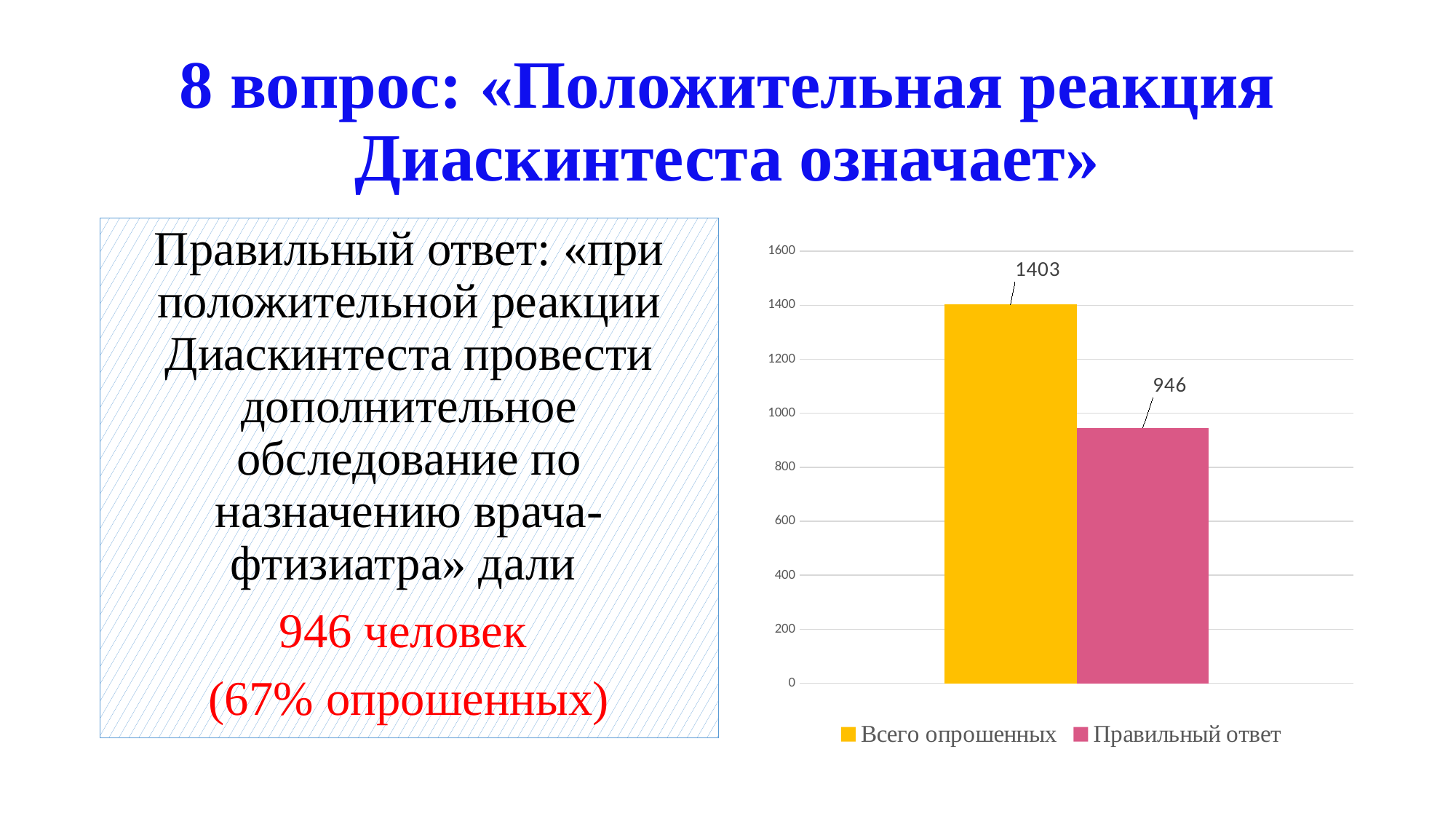
Is the value for "Правильный ответ" greater or less than 1000? less Which is larger: the value for "Всего опрошенных" or the value for "Правильный ответ"? Всего опрошенных What is the value for "Всего опрошенных" in the chart? 1403 What is the difference between the values for "Всего опрошенных" and "Правильный ответ"? 457 What is the value for "Правильный ответ" in the chart? 946 Which series has the lower value in the chart? Правильный ответ Is the value for "Всего опрошенных" greater or less than 1200? greater How many series does the legend list? 2 Which series has the higher value in the chart? Всего опрошенных What kind of chart is shown on the slide? bar chart How many bars are plotted in the chart? 2 What colour is the bar for "Правильный ответ"? pink